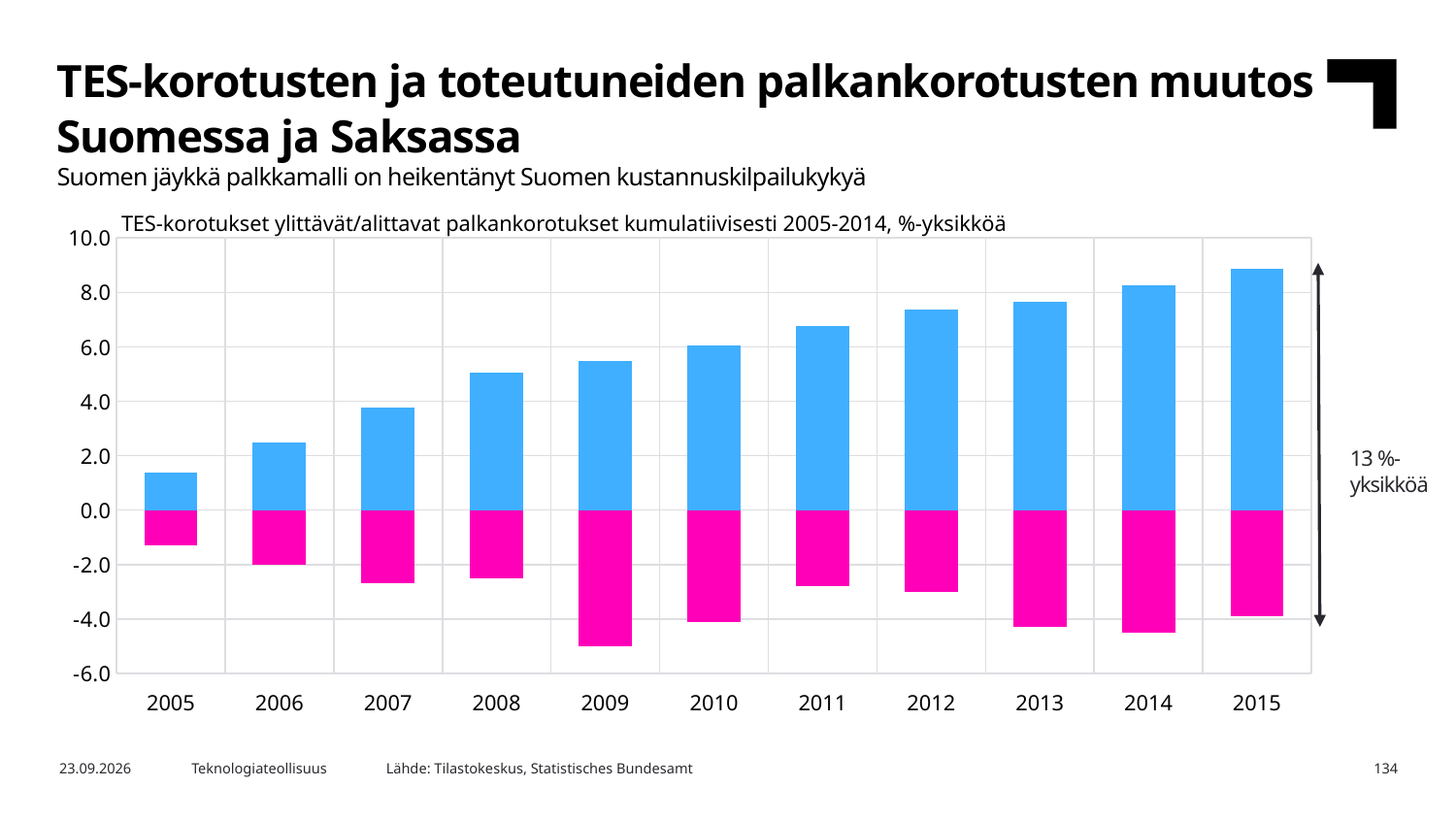
Which year has the tallest blue (positive) bar? 2015 What kind of chart is shown on the slide? bar chart Which year has the larger blue bar, 2010 or 2013? 2013 Is the blue bar for 2005 greater or less than 2.0? less Is the blue bar for 2015 greater or less than 8.0? greater Which year has the longest magenta (negative) bar? 2009 What value does the annotation with the arrow to the right of the chart state? 13 %-yksikköä Do the blue bars rise or fall from 2005 to 2015? rise How many years are shown on the x axis of the chart? 11 Which year has the shortest blue (positive) bar? 2005 Is the blue bar for 2008 greater or less than 4.0? greater